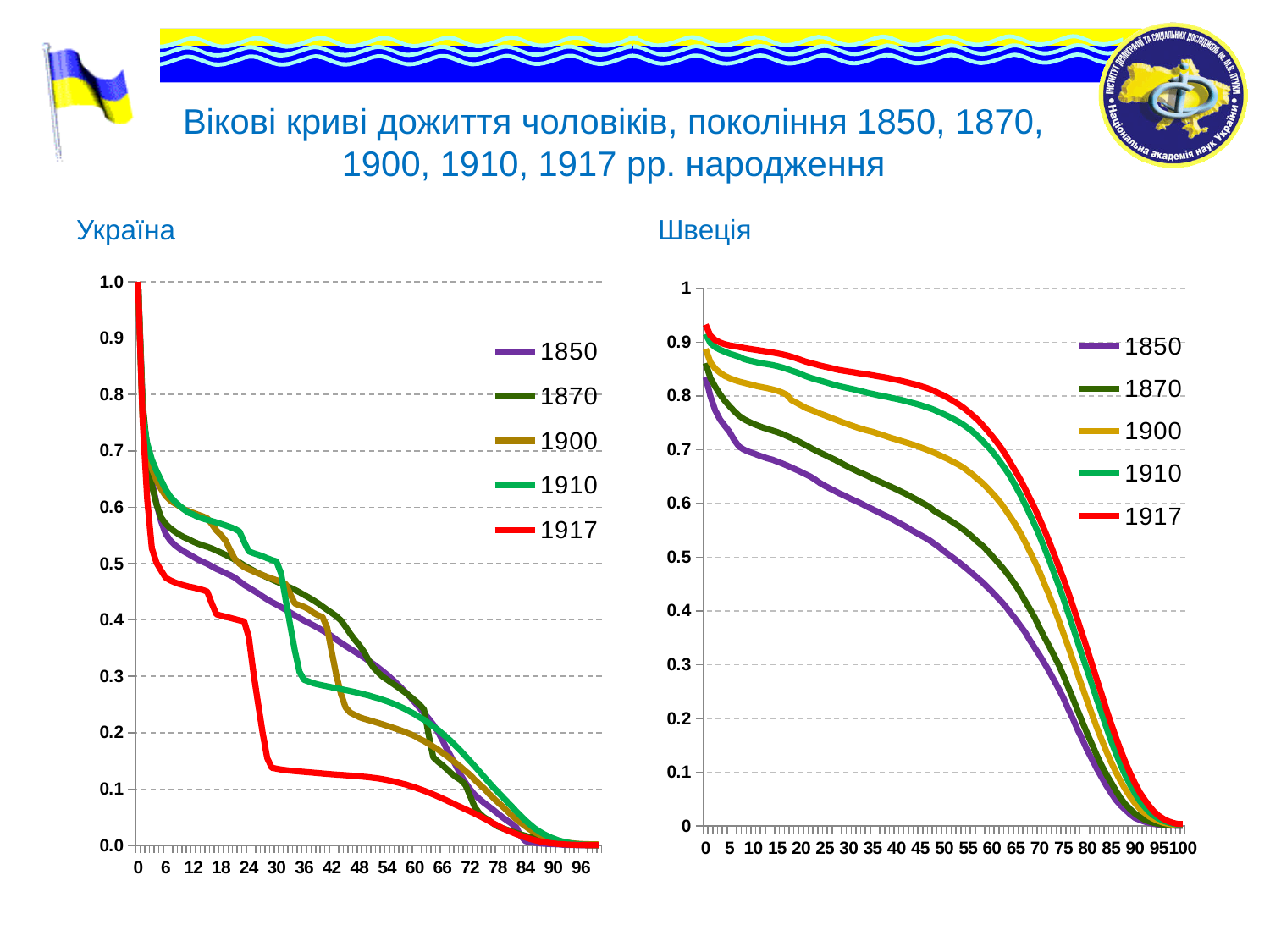
In the Швеція chart, which series has the highest value at age 50? 1917 In the Україна chart, at age 30, which series has the larger value: 1910 or 1917? 1910 In the Швеція chart, is the value of the 1917 series at age 50 greater or less than 0.7? greater What kind of chart is the Україна chart? line chart What is the label above the right-hand chart? Швеція In the Швеція chart, do the values of the 1917 series rise or fall as age increases along the x axis? fall In the Україна chart, is the value of the 1917 series at age 30 greater or less than 0.2? less In the Швеція chart, is the value of the 1850 series at age 50 greater or less than 0.6? less How many series does the legend of the Швеція chart list? 5 In the Швеція chart, which colour is used for the 1917 series? red In the Швеція chart, which series has the lowest value at age 50? 1850 In the Україна chart, at age 48, which series has the larger value: 1870 or 1900? 1870